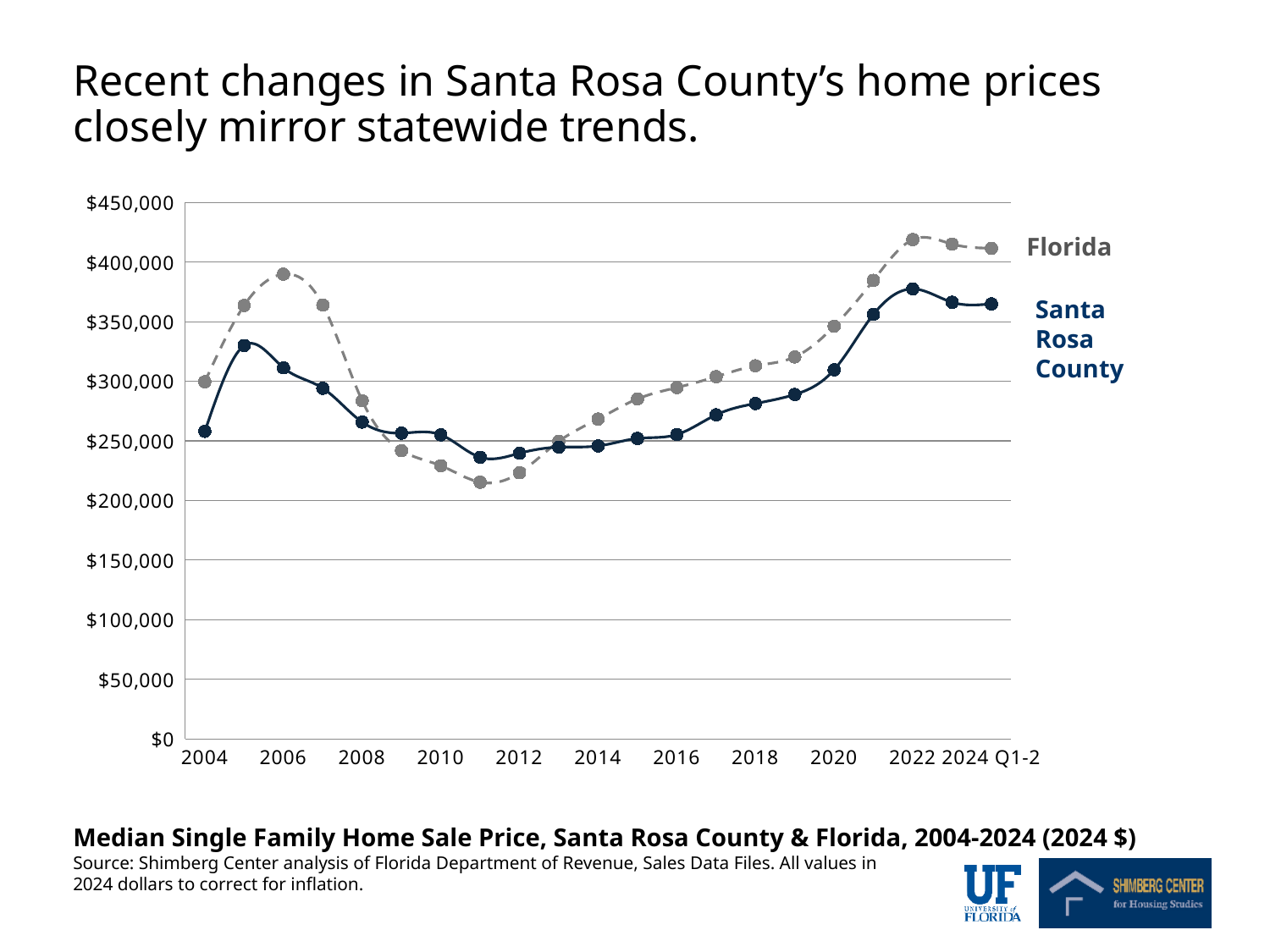
Is the Santa Rosa County value for 2011 greater or less than $250,000? less Is the Santa Rosa County value for 2022 greater or less than $400,000? less How many data points does each series have on the chart? 21 What kind of chart is shown on the slide? Line chart Is the Florida value for 2006 greater or less than $350,000? greater In 2010, which series has the higher value, Florida or Santa Rosa County? Santa Rosa County In 2020, which series has the higher value, Florida or Santa Rosa County? Florida In which year does the Florida series reach its lowest value? 2011 Does the Santa Rosa County series rise or fall between 2005 and 2011? fall In which year does the Florida series reach its highest value? 2022 How many series does the chart plot? 2